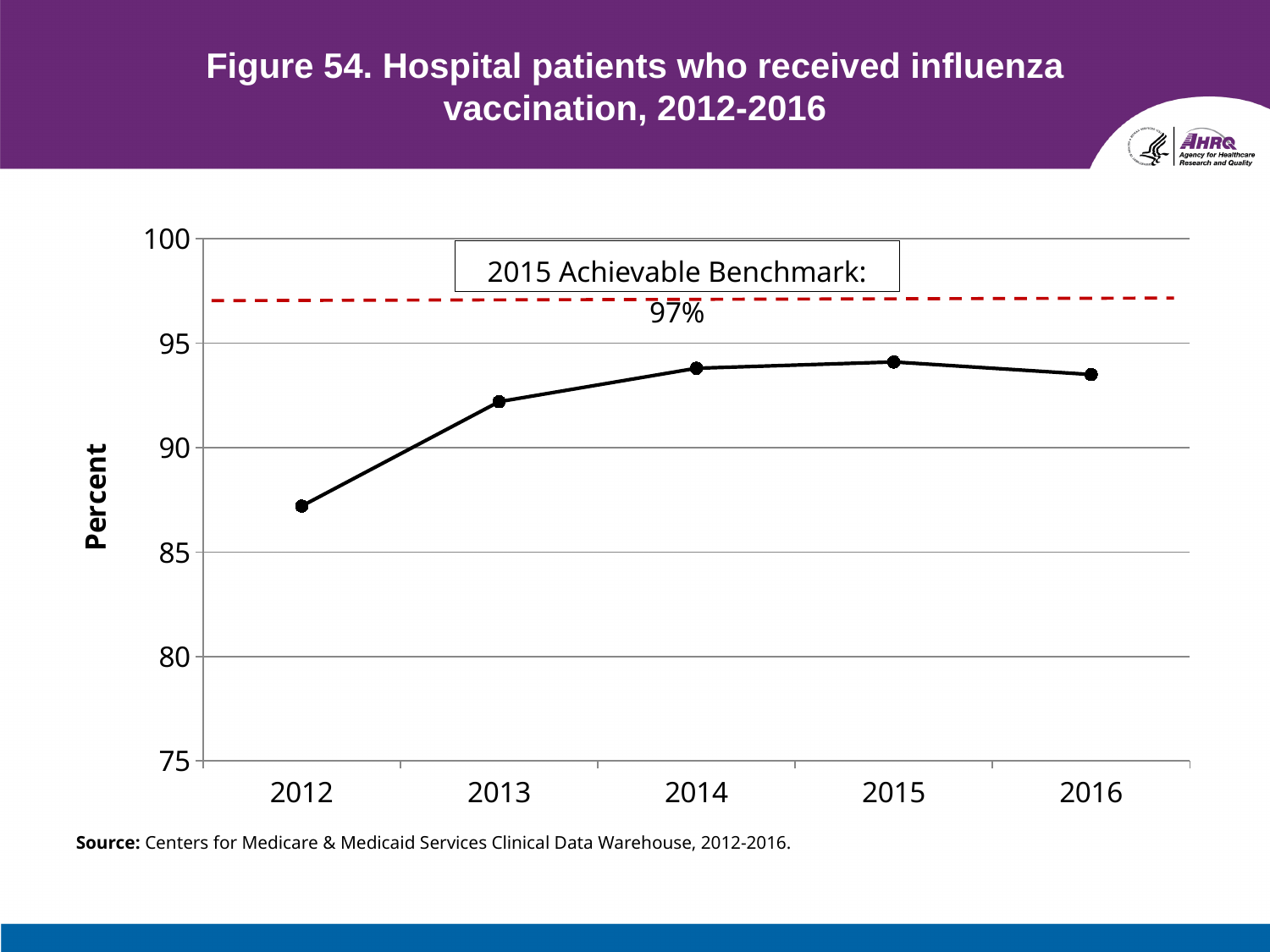
Which year has the lowest value? 2012 Is the value for 2013 greater or less than 90? greater What is the label on the vertical axis? Percent Which is larger, the value for 2012 or the value for 2016? 2016 How many data points are plotted on the line? 5 Is the value for 2016 greater or less than 90? greater What kind of chart is shown on the slide? line chart Which is larger, the value for 2012 or the value for 2013? 2013 Is the value for 2015 greater or less than 95? less What is the 2015 Achievable Benchmark shown on the chart? 97% Does the value rise or fall from 2012 to 2013? rise